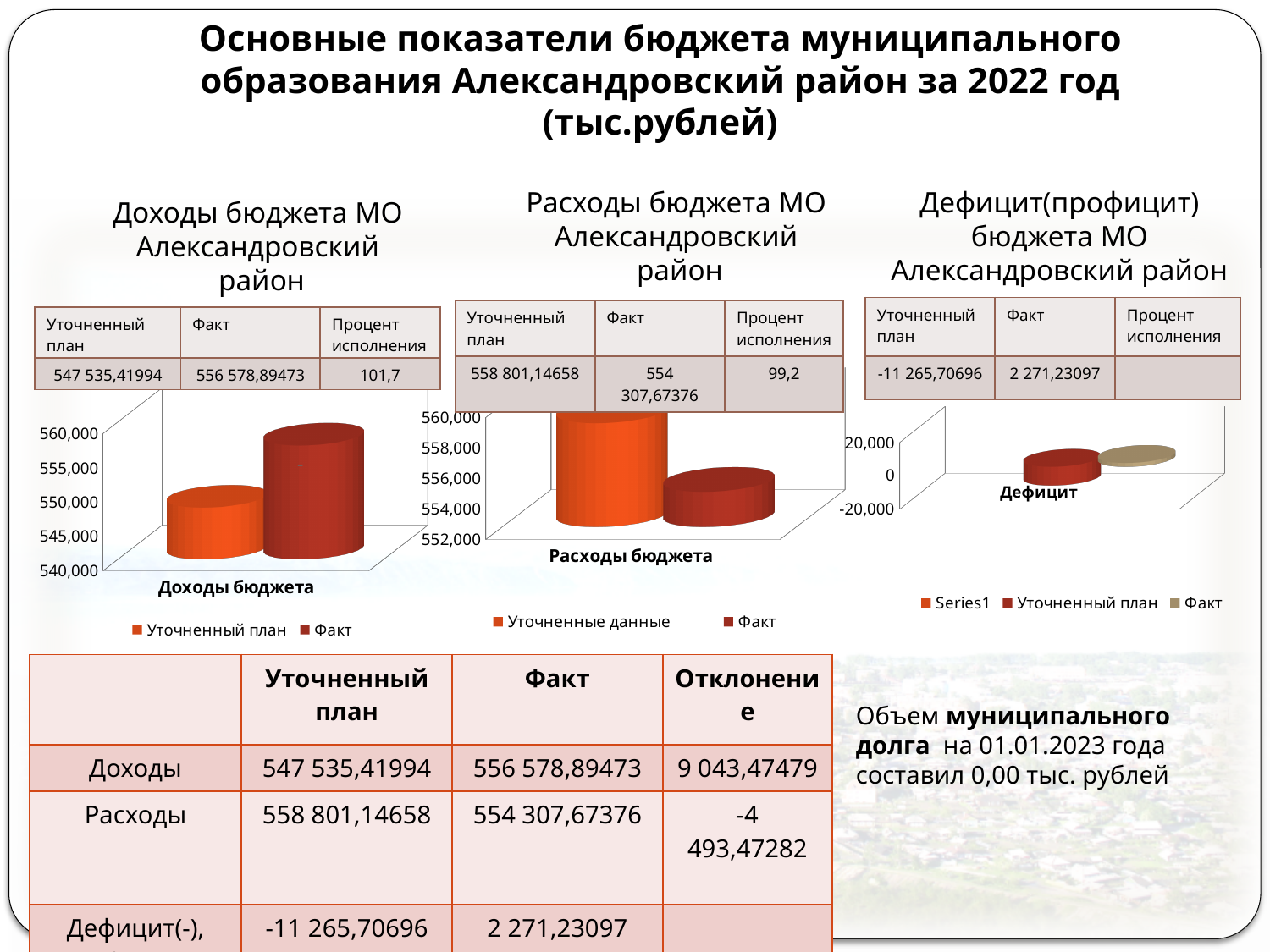
In the 'Доходы бюджета МО Александровский район' chart, what is the Процент исполнения shown in the table above the chart? 101,7 In the 'Расходы бюджета МО Александровский район' chart, what is the Уточненный план value shown in the table above the chart? 558 801,14658 How many series does the legend of the 'Дефицит(профицит) бюджета МО Александровский район' chart list? 3 In the 'Дефицит(профицит) бюджета МО Александровский район' chart, what is the Факт value shown in the table above the chart? 2 271,23097 How many series does the legend of the 'Доходы бюджета МО Александровский район' chart list? 2 In the 'Расходы бюджета МО Александровский район' chart, which is larger: Уточненный план or Факт? Уточненный план In the 'Доходы бюджета МО Александровский район' chart, is the value for Факт greater or less than 550,000? greater What kind of chart is the 'Доходы бюджета МО Александровский район' chart? bar chart For Доходы, what is the difference (Отклонение) between Факт and Уточненный план as shown in the bottom table? 9 043,47479 In the 'Доходы бюджета МО Александровский район' chart, which is larger: Уточненный план or Факт? Факт In the 'Расходы бюджета МО Александровский район' chart, is the value for Факт greater or less than 558,000? less What is the first legend entry of the 'Расходы бюджета МО Александровский район' chart? Уточненные данные